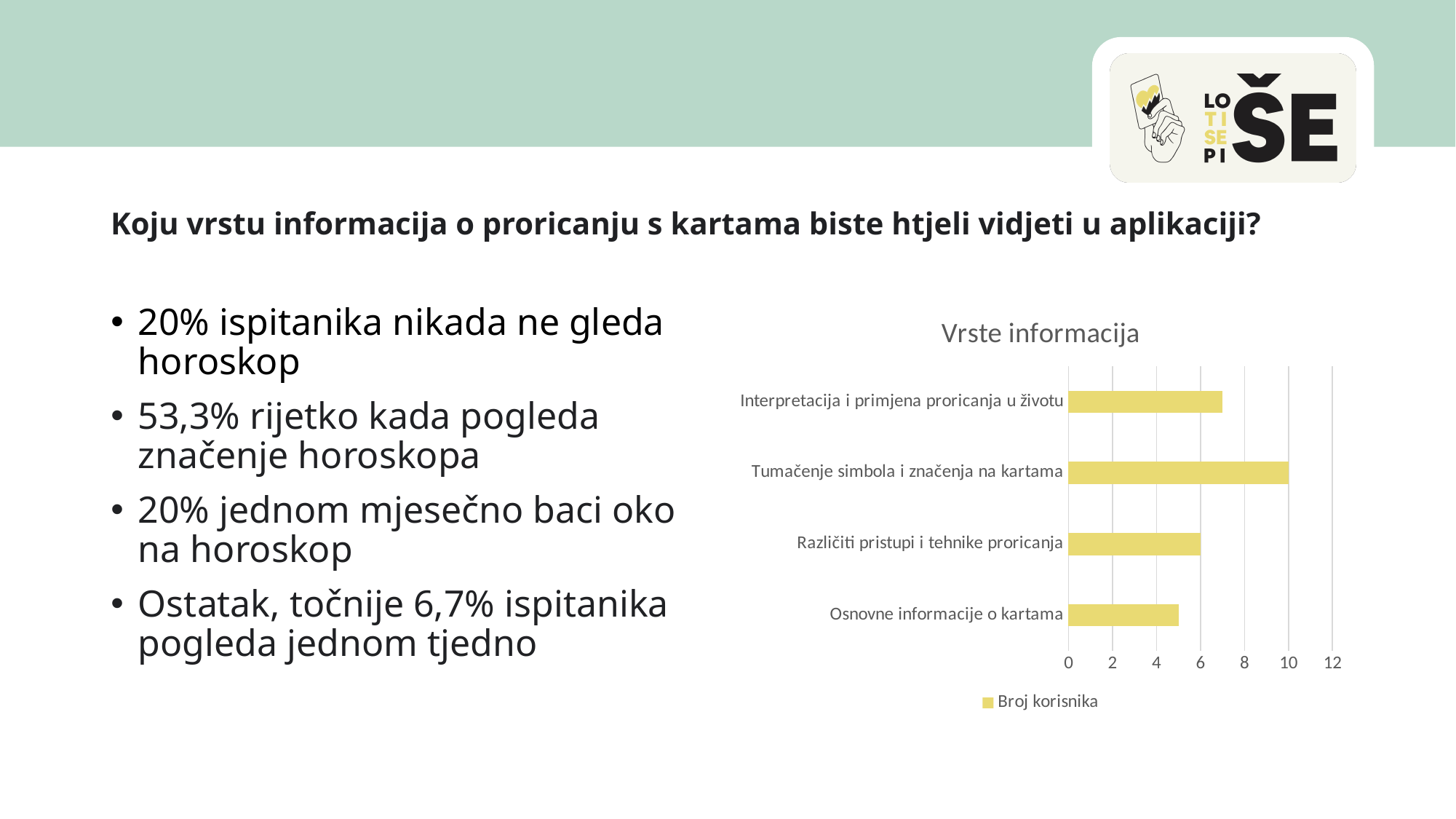
Which category has the highest value? Tumačenje simbola i značenja na kartama Is the value for Interpretacija i primjena proricanja u životu greater or less than 6? greater What is the value for Različiti pristupi i tehnike proricanja? 6 How many categories are shown in the chart? 4 Is the value for Osnovne informacije o kartama greater or less than 6? less What is the name of the series shown in the chart legend? Broj korisnika What kind of chart is shown on the slide? bar chart What is the title of the chart? Vrste informacija How many series does the chart legend list? 1 What is the difference between the values for Tumačenje simbola i značenja na kartama and Različiti pristupi i tehnike proricanja? 4 What is the value for Tumačenje simbola i značenja na kartama? 10 Which category has the lowest value? Osnovne informacije o kartama